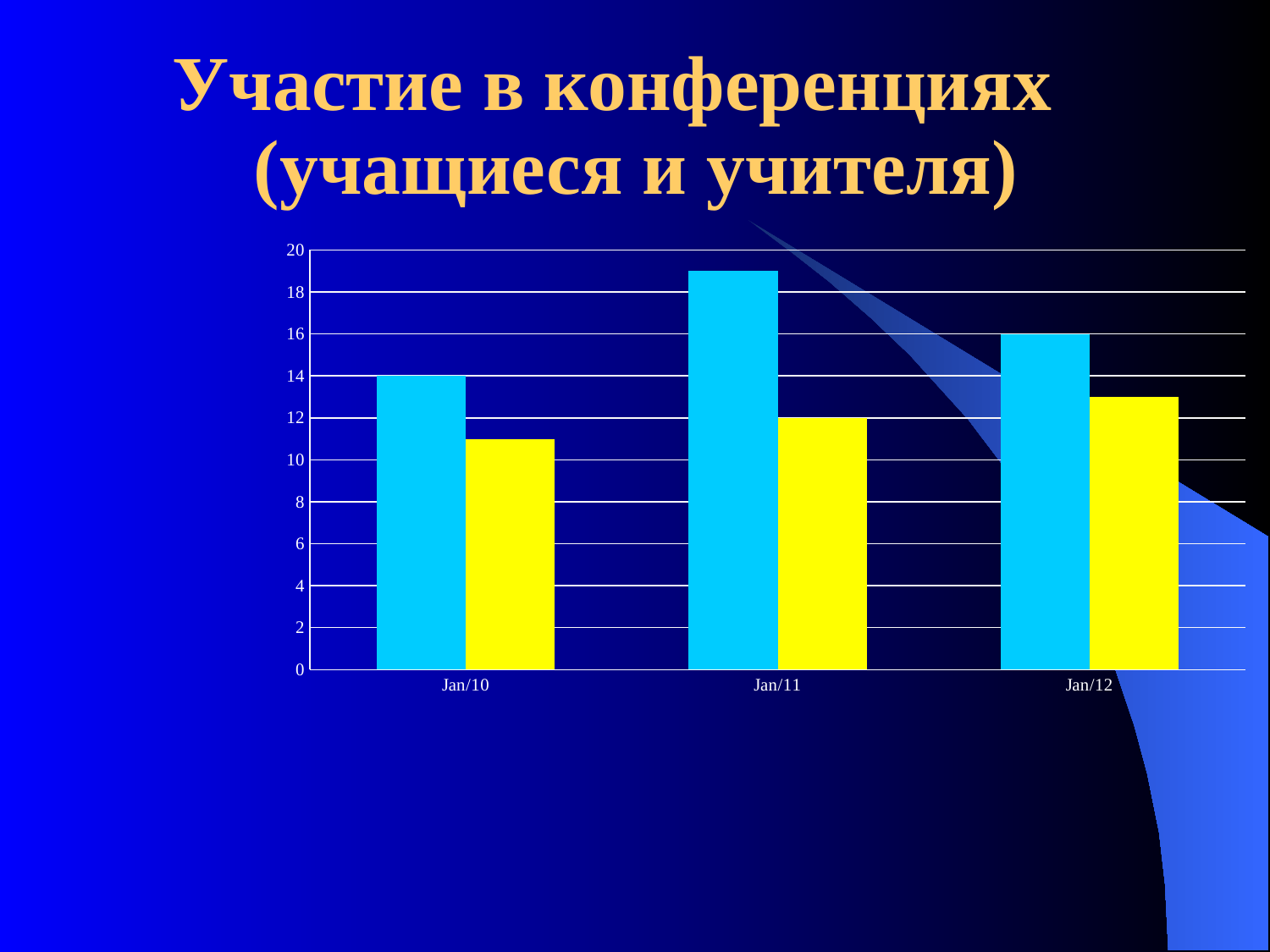
What kind of chart is shown on the slide? bar chart Is the value of the yellow bar for Jan/10 greater or less than 12? less Is the value of the yellow bar for Jan/12 greater or less than 12? greater How many categories are shown on the x axis of the chart? 3 What is the difference between the light blue bar for Jan/12 and the light blue bar for Jan/10? 2 In which category is the yellow bar the shortest? Jan/10 What is the value of the light blue bar for Jan/10? 14 Is the value of the light blue bar for Jan/11 greater or less than 18? greater What is the value of the yellow bar for Jan/11? 12 What is the value of the light blue bar for Jan/12? 16 In which category is the light blue bar the tallest? Jan/11 For Jan/10, which bar is taller, the light blue one or the yellow one? the light blue one